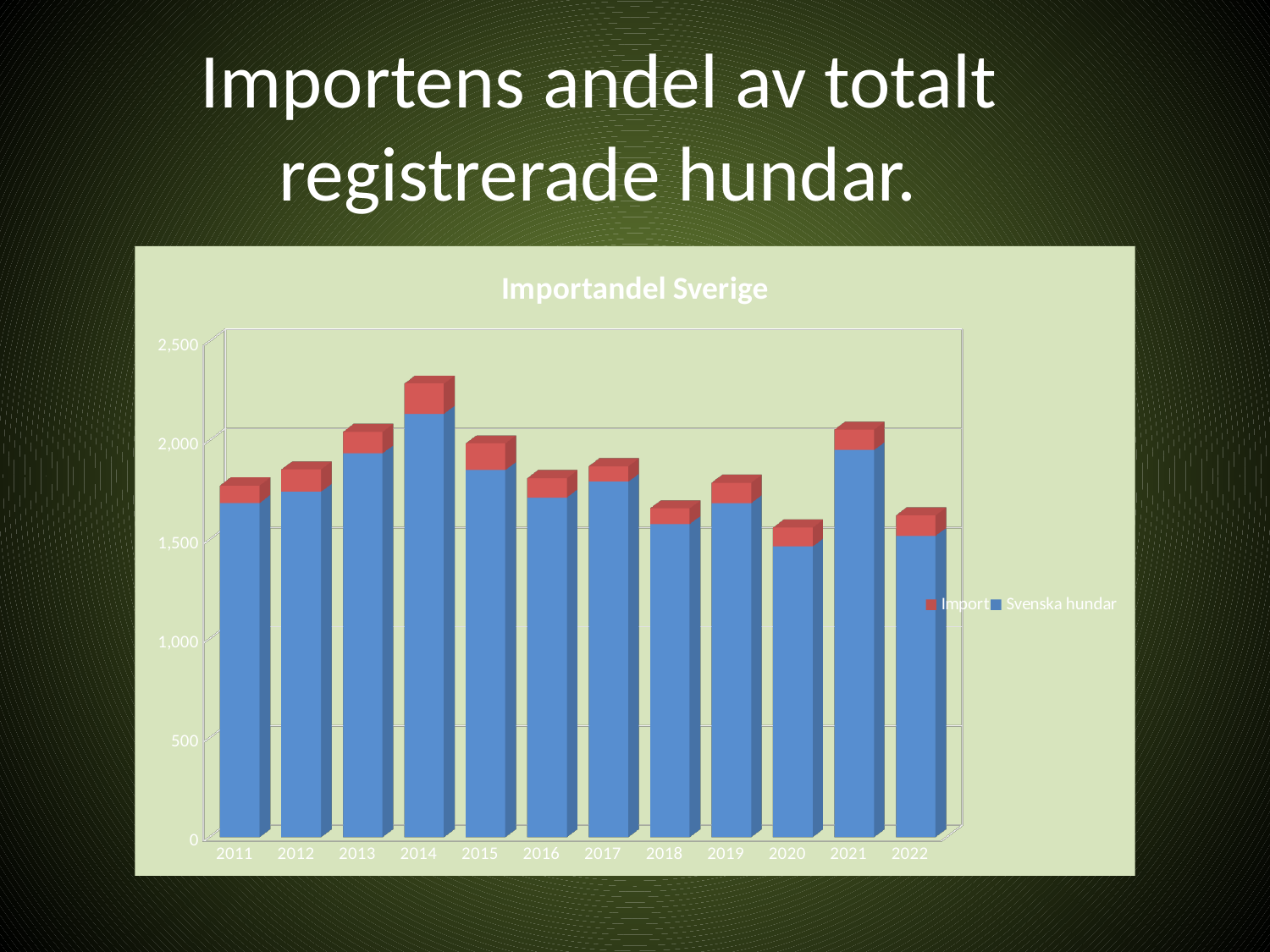
Which year has the lowest total bar in the chart? 2020 Is the total value for 2014 greater or less than 2,000? greater Which year has the larger total bar, 2014 or 2020? 2014 How many series does the chart legend list? 2 What is the title of the chart? Importandel Sverige Do the total bar values rise or fall from 2011 to 2014? rise Which year has the highest total bar in the chart? 2014 How many years are shown on the x axis of the chart? 12 Is the total value for 2018 greater or less than 2,000? less Which series is shown in red in the chart? Import Is the total value for 2011 greater or less than 1,500? greater What kind of chart is shown on the slide? Stacked bar chart